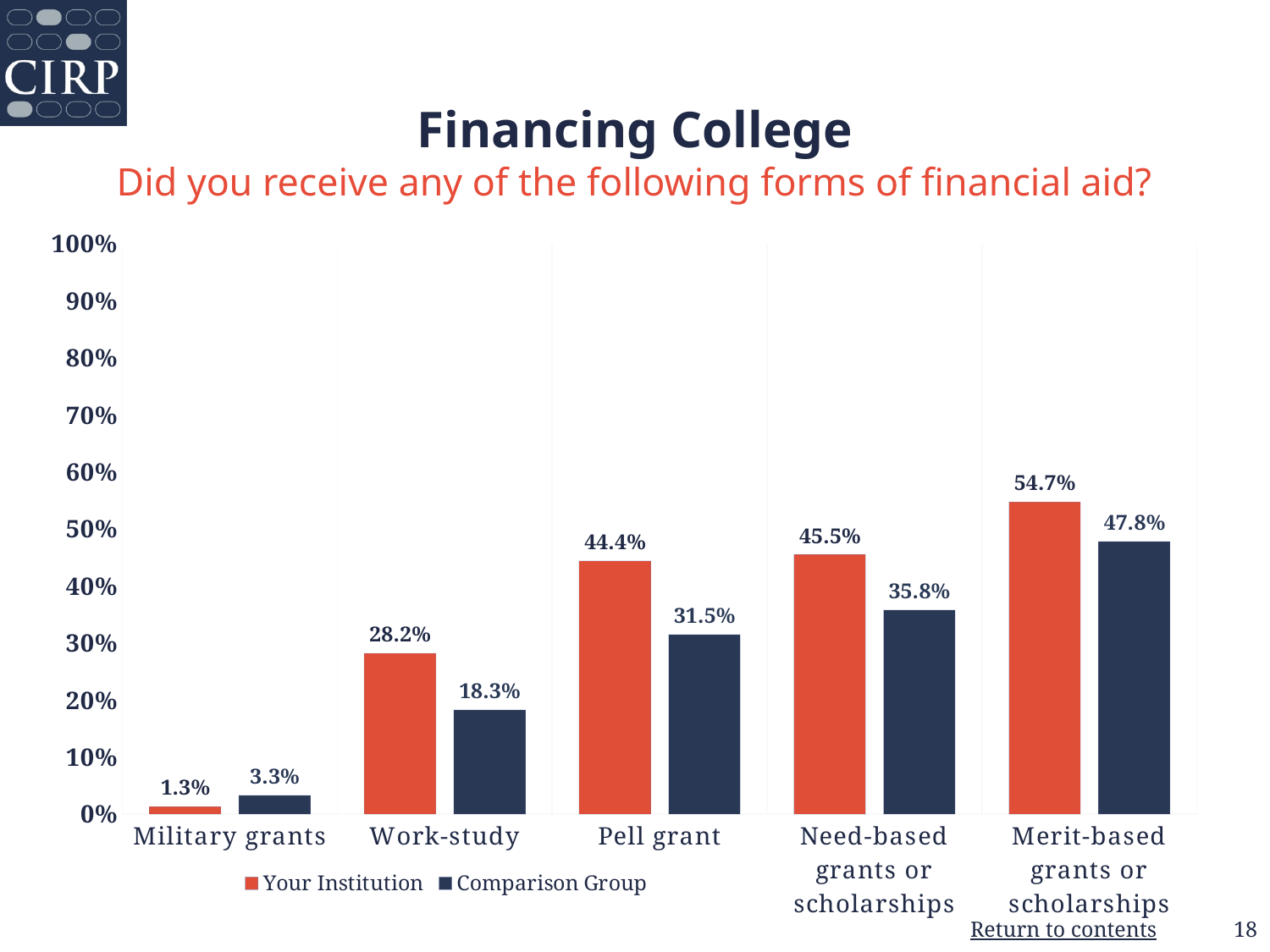
Is the value for Your Institution for Merit-based grants or scholarships greater or less than 50%? greater What colour are the bars for Your Institution? orange-red What kind of chart is shown on the slide? bar chart Which category has the highest value for Your Institution? Merit-based grants or scholarships Which is larger for Military grants: Your Institution or Comparison Group? Comparison Group How many categories are shown on the x axis? 5 What is the value for Comparison Group for Military grants? 3.3% Which category has the lowest value for Comparison Group? Military grants How many series does the legend list? 2 What is the difference between Your Institution and Comparison Group for Need-based grants or scholarships? 9.7% What is the value for Your Institution for Pell grant? 44.4% What is the value for Comparison Group for Work-study? 18.3%